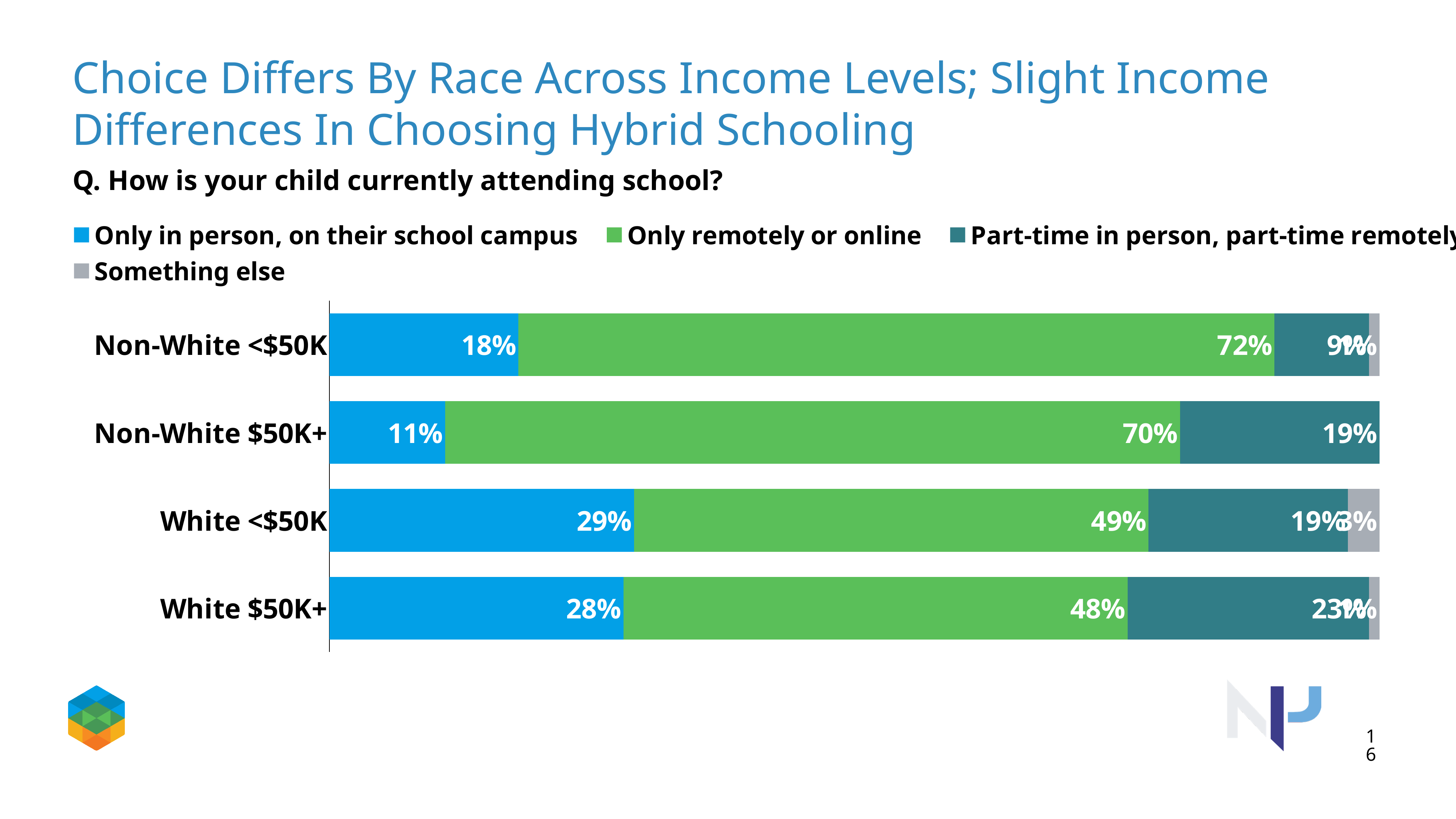
What percentage of Non-White $50K+ respondents said their child attends part-time in person, part-time remotely? 19% Which group has the lowest share of children attending only in person, on their school campus? Non-White $50K+ What percentage of White <$50K respondents said their child attends only in person, on their school campus? 29% What is the difference in percentage points between the 'Only in person' share for White <$50K and Non-White $50K+? 18 What type of chart is shown on the slide? Stacked bar chart Which is larger: the 'Only remotely or online' share for Non-White <$50K or for Non-White $50K+? Non-White <$50K What percentage of White $50K+ respondents said their child attends only remotely or online? 48% What percentage of Non-White $50K+ respondents said their child attends only in person, on their school campus? 11% How many series does the legend list? 4 What percentage of Non-White <$50K respondents said their child attends only remotely or online? 72% Which group has the highest share of children attending only remotely or online? Non-White <$50K How many groups (bars) are shown in the chart? 4